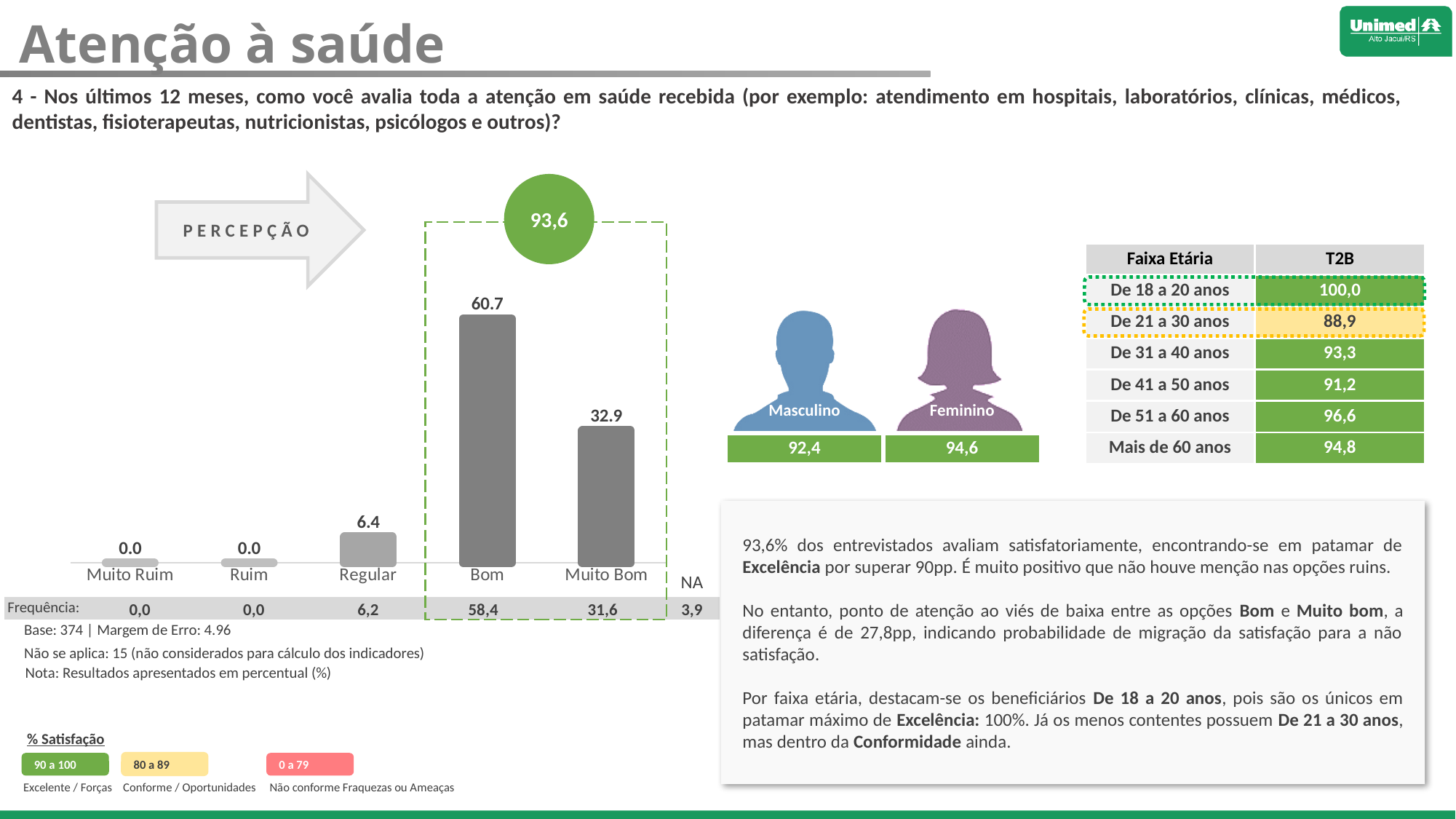
Which is larger, the value for Regular or the value for Muito Bom? Muito Bom What is the value for Regular in the bar chart? 6.4 What is the difference between the values for Bom and Muito Bom? 27.8 What is the value for Muito Bom in the bar chart? 32.9 What value is shown in the green circle above the bar chart? 93,6 Which two categories are enclosed by the green dashed box in the bar chart? Bom and Muito Bom What kind of chart is shown on the slide? bar chart What is the value for Bom in the bar chart? 60.7 How many categories are shown in the bar chart? 5 Do the values rise or fall from Bom to Muito Bom along the x axis? fall Which category has the highest value in the bar chart? Bom What is the value for Ruim in the bar chart? 0.0